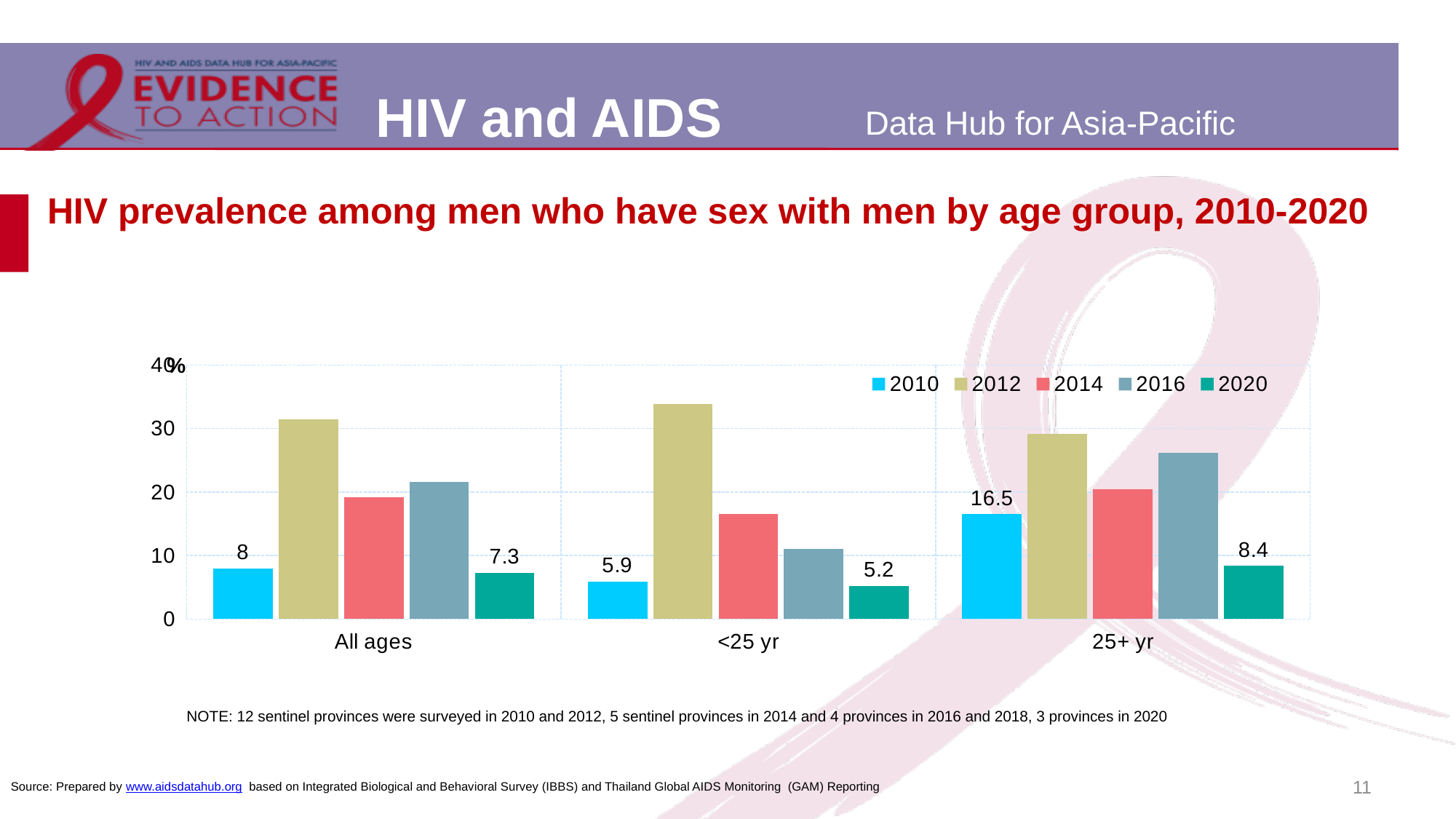
What is the HIV prevalence for All ages in 2010? 8 Which age group has the highest value in 2010? 25+ yr What is the value for the 25+ yr group in 2010? 16.5 Which age group has the lowest value in 2020? <25 yr Which year has the highest bar in the <25 yr group? 2012 What kind of chart is shown on the slide? bar chart What is the value for the 25+ yr group in 2020? 8.4 Is the 2012 value for the <25 yr group greater or less than 30? greater Is the 2014 value for the <25 yr group greater or less than 20? less What is the value for the <25 yr group in 2020? 5.2 What is the difference between the 2010 and 2020 values for the 25+ yr group? 8.1 How many series does the legend list? 5